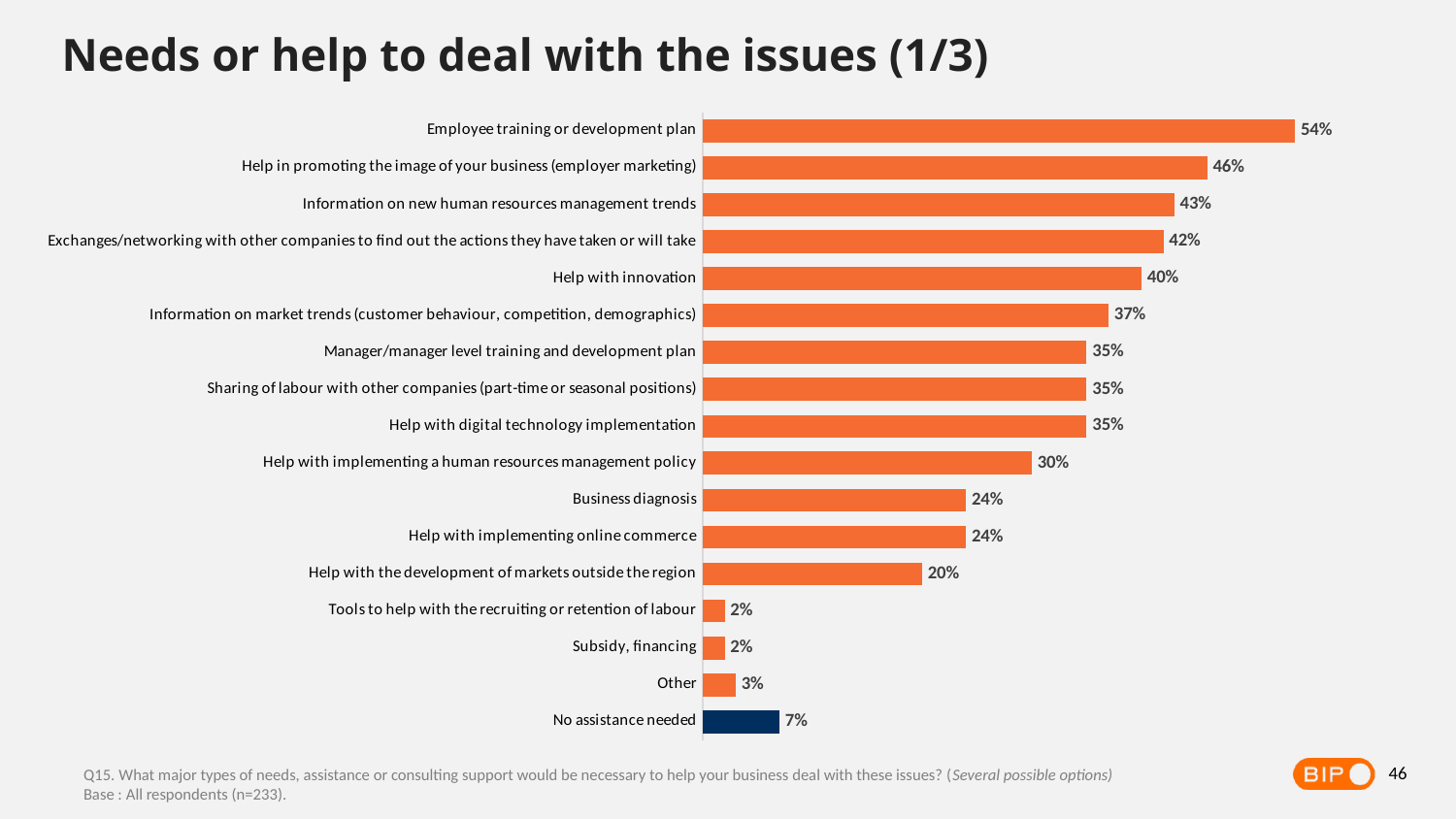
What is the value for 'Help with the development of markets outside the region'? 20% Which category is shown in a different colour (dark blue) from the others? No assistance needed Which category has the highest value? Employee training or development plan What is the value for 'Information on market trends (customer behaviour, competition, demographics)'? 37% What is the value for 'Help with innovation'? 40% What percentage of respondents selected 'Employee training or development plan'? 54% What is the difference between 'Employee training or development plan' and 'Help in promoting the image of your business (employer marketing)'? 8% What is the difference between 'Other' and 'Subsidy, financing'? 1% What is the value for 'No assistance needed'? 7% How many categories are shown in the chart? 17 Which is larger: 'Business diagnosis' or 'Help with implementing a human resources management policy'? Help with implementing a human resources management policy What type of chart is shown on the slide? Bar chart